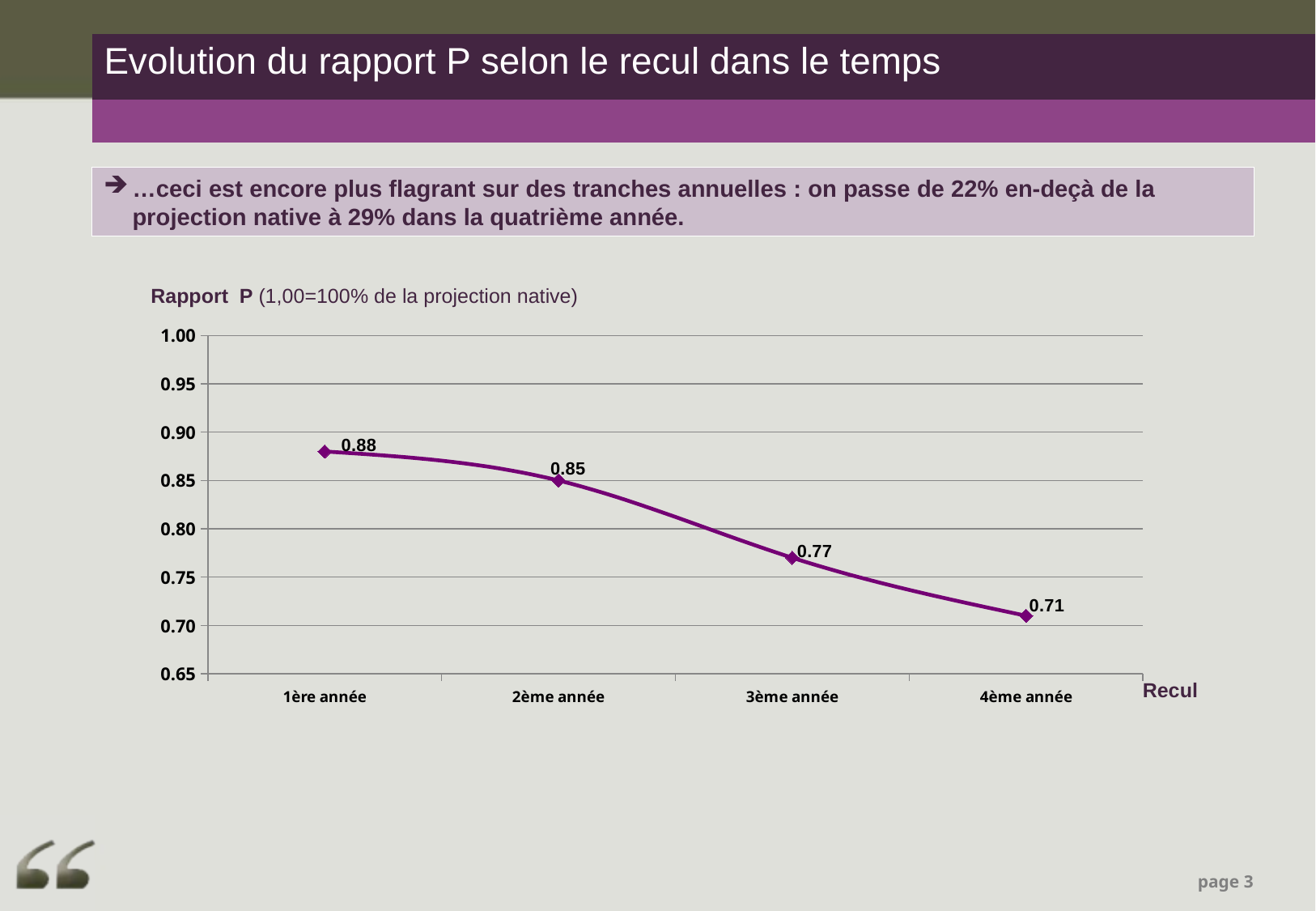
What is the Rapport P value for 1ère année? 0.88 Is the Rapport P value for 3ème année greater or less than 0.80? less Which year has the lowest Rapport P value? 4ème année Which year has the highest Rapport P value? 1ère année What is the Rapport P value for 3ème année? 0.77 How many years (data points) are plotted on the chart? 4 Do the Rapport P values rise or fall from 1ère année to 4ème année? fall What kind of chart is shown on the slide? line chart What is the difference between the Rapport P values for 1ère année and 4ème année? 0.17 Which is larger, the Rapport P value for 2ème année or for 3ème année? 2ème année What is the difference between the Rapport P values for 2ème année and 3ème année? 0.08 What is the Rapport P value for 4ème année? 0.71